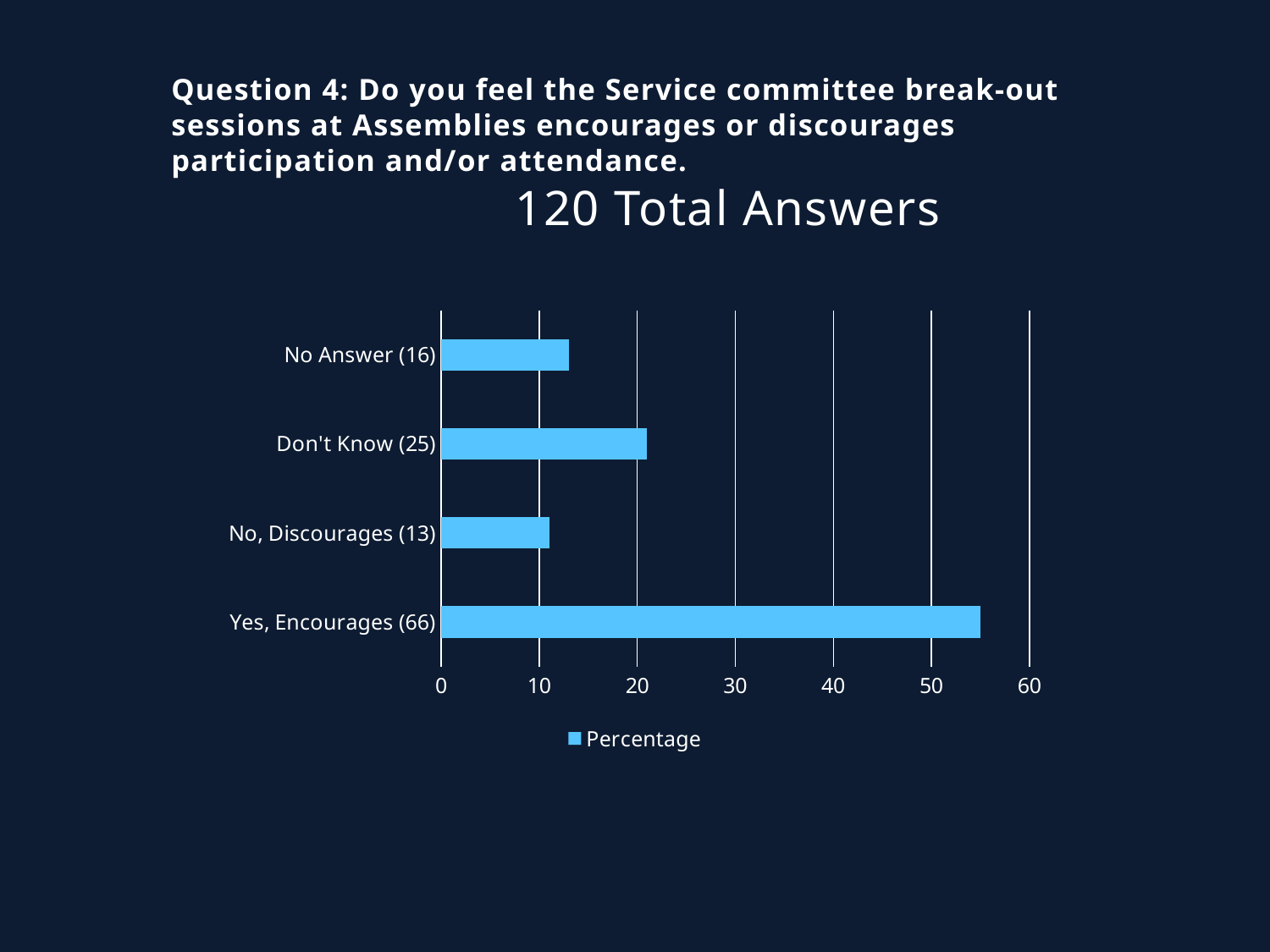
What is the name of the series shown in the legend? Percentage Which category has the highest percentage? Yes, Encourages (66) How many total answers does the chart heading report? 120 How many categories are plotted in the chart? 4 How many series does the legend list? 1 Is the value for Yes, Encourages greater or less than 50? greater What type of chart is shown on the slide? bar chart Which has a larger percentage, Don't Know or No Answer? Don't Know Is the value for No, Discourages greater or less than 20? less Which category has the lowest percentage? No, Discourages (13) Is the value for No Answer greater or less than 20? less